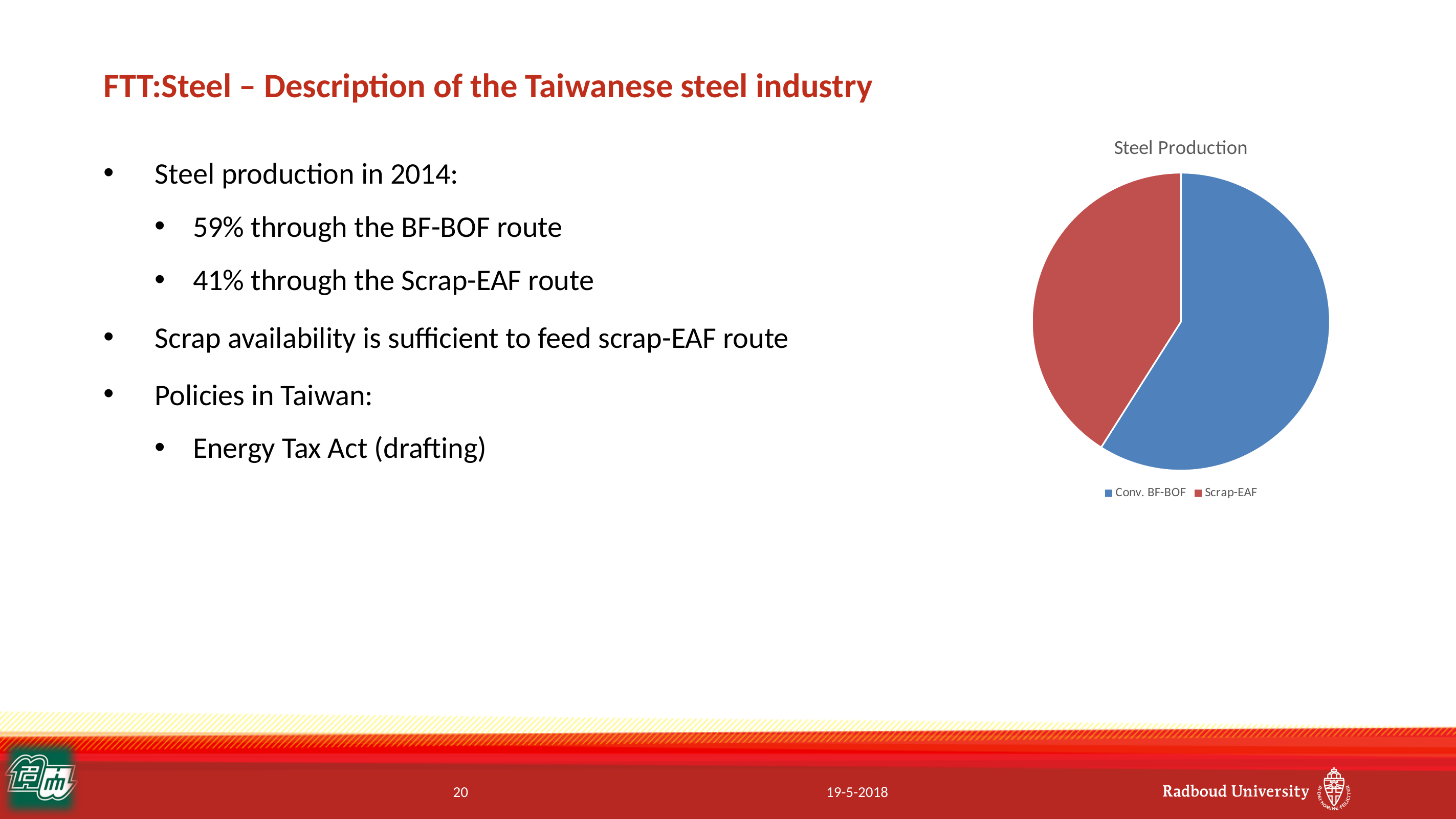
How many entries does the chart legend list? 2 What share of steel production does the Scrap-EAF slice represent? 41% What share of steel production does the Conv. BF-BOF slice represent? 59% Which colour represents Scrap-EAF in the pie chart? red What kind of chart is shown on the slide? pie chart Which is larger in the pie chart, Conv. BF-BOF or Scrap-EAF? Conv. BF-BOF What is the title of the chart? Steel Production Which slice of the pie chart is the smallest? Scrap-EAF Which slice of the pie chart is the largest? Conv. BF-BOF How many slices does the pie chart have? 2 What is the difference in percentage points between the BF-BOF share and the Scrap-EAF share? 18 Is the Conv. BF-BOF slice greater or less than half of the pie? greater